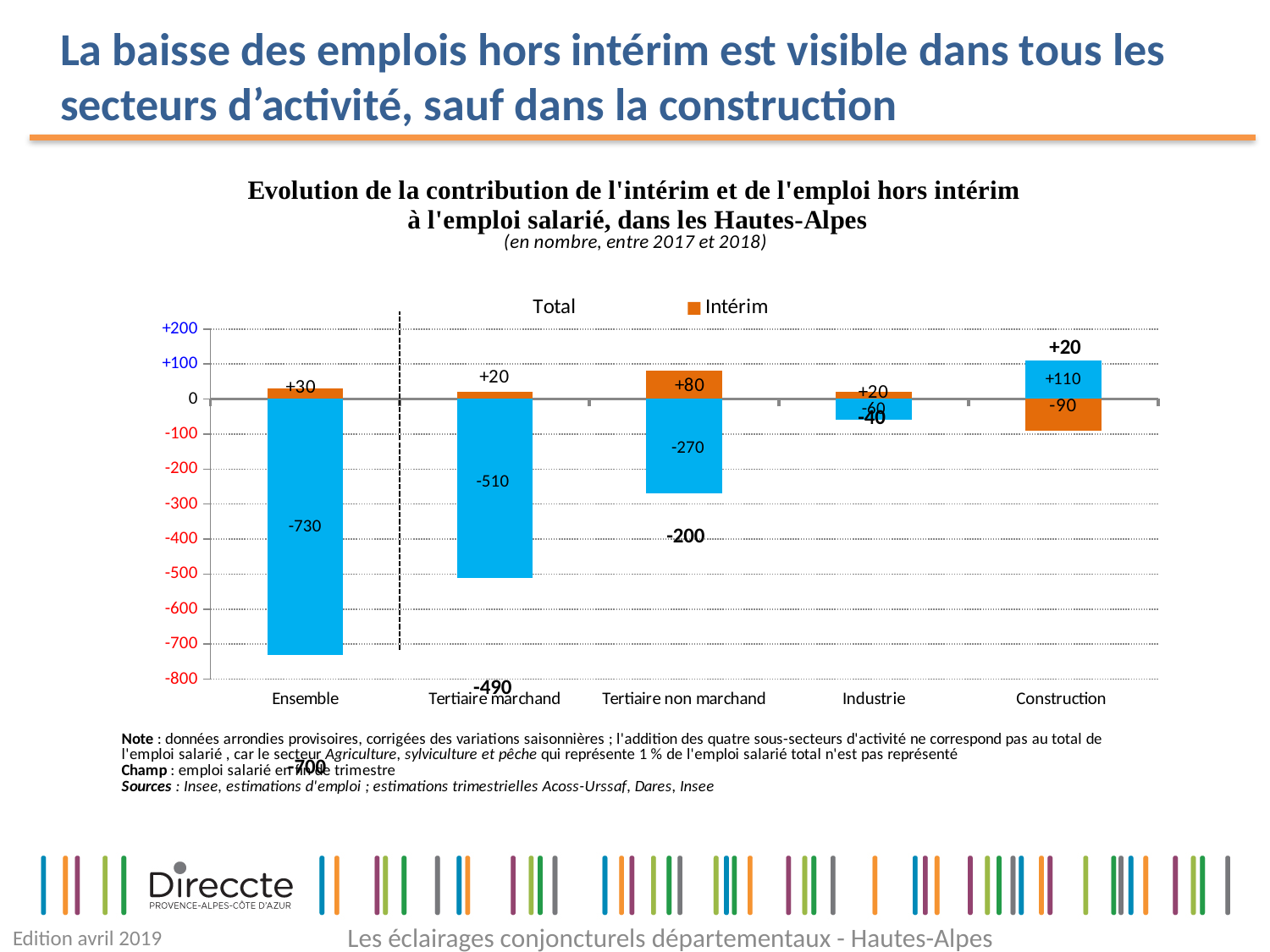
What is the total (sum of both series) printed for Construction? +20 What is the value of the blue bar for Construction? +110 Which is larger, the Intérim value for Ensemble or the Intérim value for Tertiaire marchand? Ensemble What is the Intérim (orange) value for Tertiaire non marchand? +80 How many sector categories are shown along the x axis of the chart? 5 What is the value of the blue bar for Ensemble? -730 What kind of chart is shown on the slide? bar chart How many series does the chart's legend list? 2 Which category has the lowest blue bar value? Ensemble What is the Intérim (orange) value for Construction? -90 Which category has the highest Intérim (orange) value? Tertiaire non marchand What is the difference between the blue bar values for Tertiaire marchand (-510) and Tertiaire non marchand (-270)? 240